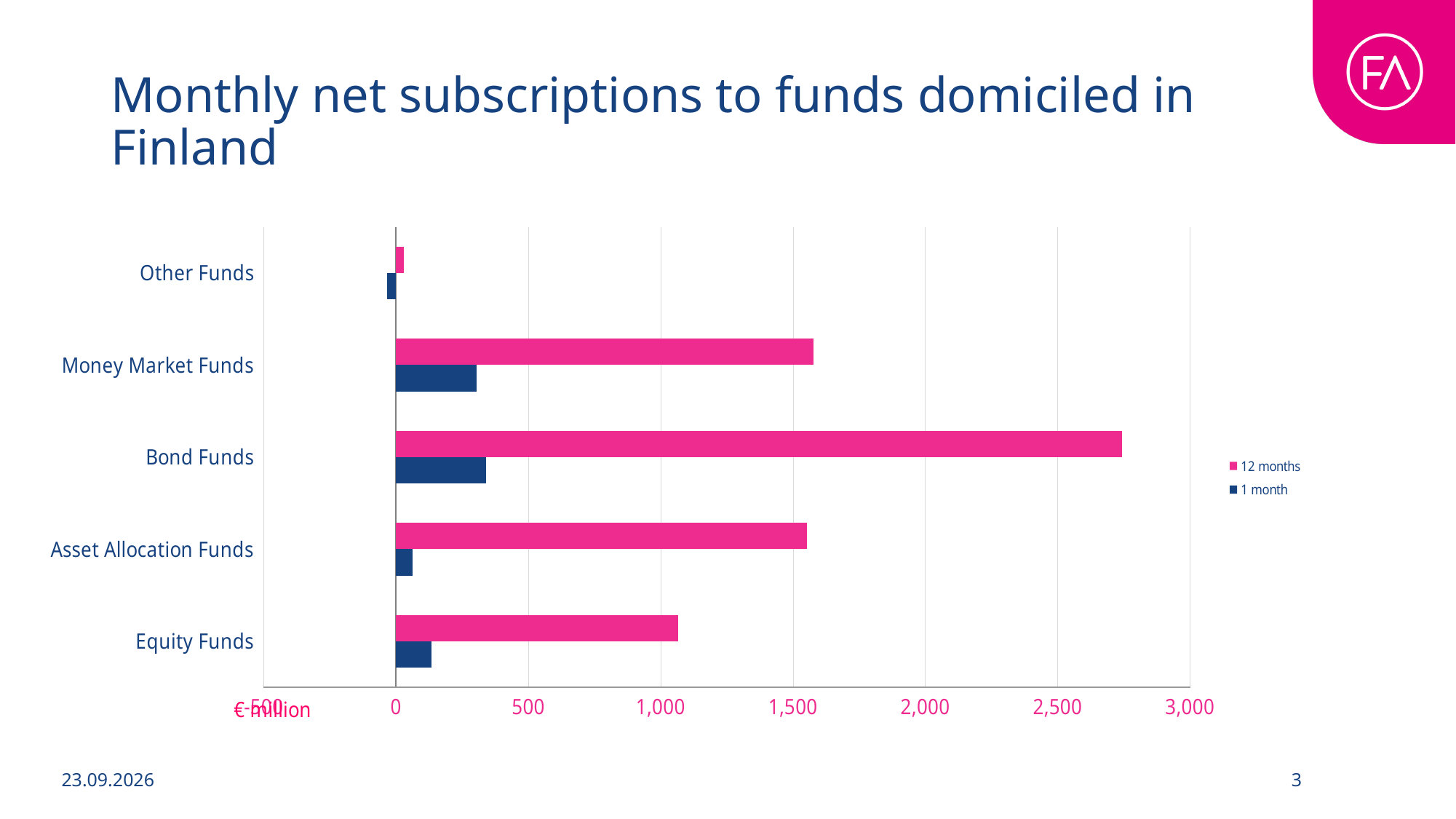
Which fund category has the highest 12 months value? Bond Funds Which fund category has the lowest 12 months value? Other Funds Is the 12 months value for Equity Funds greater or less than 1,000? greater Which fund category has the lowest 1 month value? Other Funds Which is larger, the 12 months value for Bond Funds or the 12 months value for Equity Funds? Bond Funds How many series does the legend list? 2 Which is larger, the 1 month value for Bond Funds or the 1 month value for Asset Allocation Funds? Bond Funds Is the 1 month value for Money Market Funds greater or less than 500? less Is the 12 months value for Bond Funds greater or less than 2,500? greater What kind of chart is shown on the slide? bar chart How many fund categories are shown on the chart? 5 What are the two series named in the legend? 12 months and 1 month